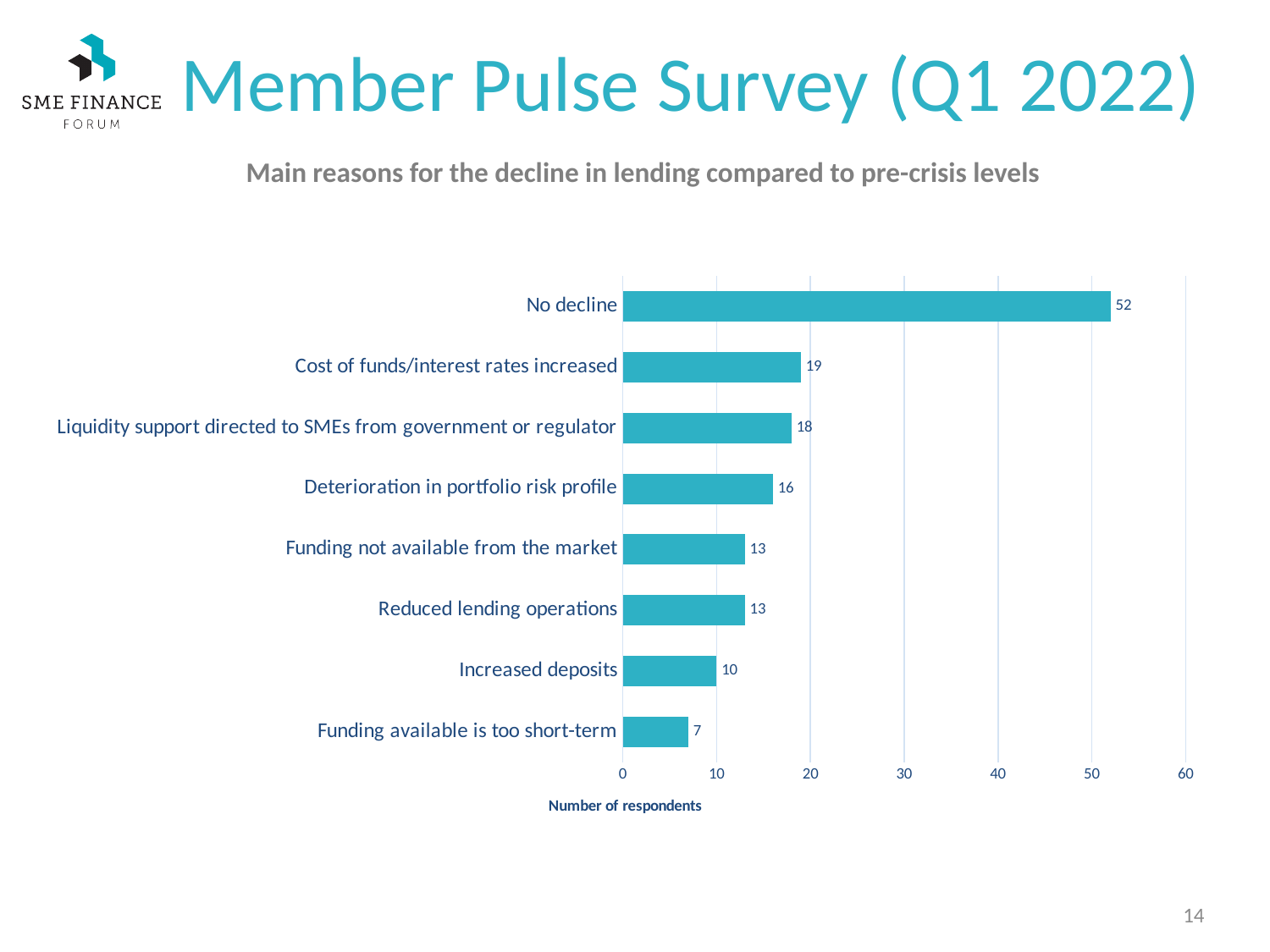
Which category has the lowest number of respondents? Funding available is too short-term How many respondents selected "No decline"? 52 What is the difference between "Deterioration in portfolio risk profile" and "Funding available is too short-term"? 9 What is the difference in respondents between "No decline" and "Cost of funds/interest rates increased"? 33 Which category has the highest number of respondents? No decline How many categories are shown in the chart? 8 What is the number of respondents for "Cost of funds/interest rates increased"? 19 What is the label of the horizontal axis? Number of respondents What is the value for "Liquidity support directed to SMEs from government or regulator"? 18 How many respondents chose "Increased deposits"? 10 Which has more respondents: "Deterioration in portfolio risk profile" or "Reduced lending operations"? Deterioration in portfolio risk profile What type of chart is shown on the slide? Bar chart